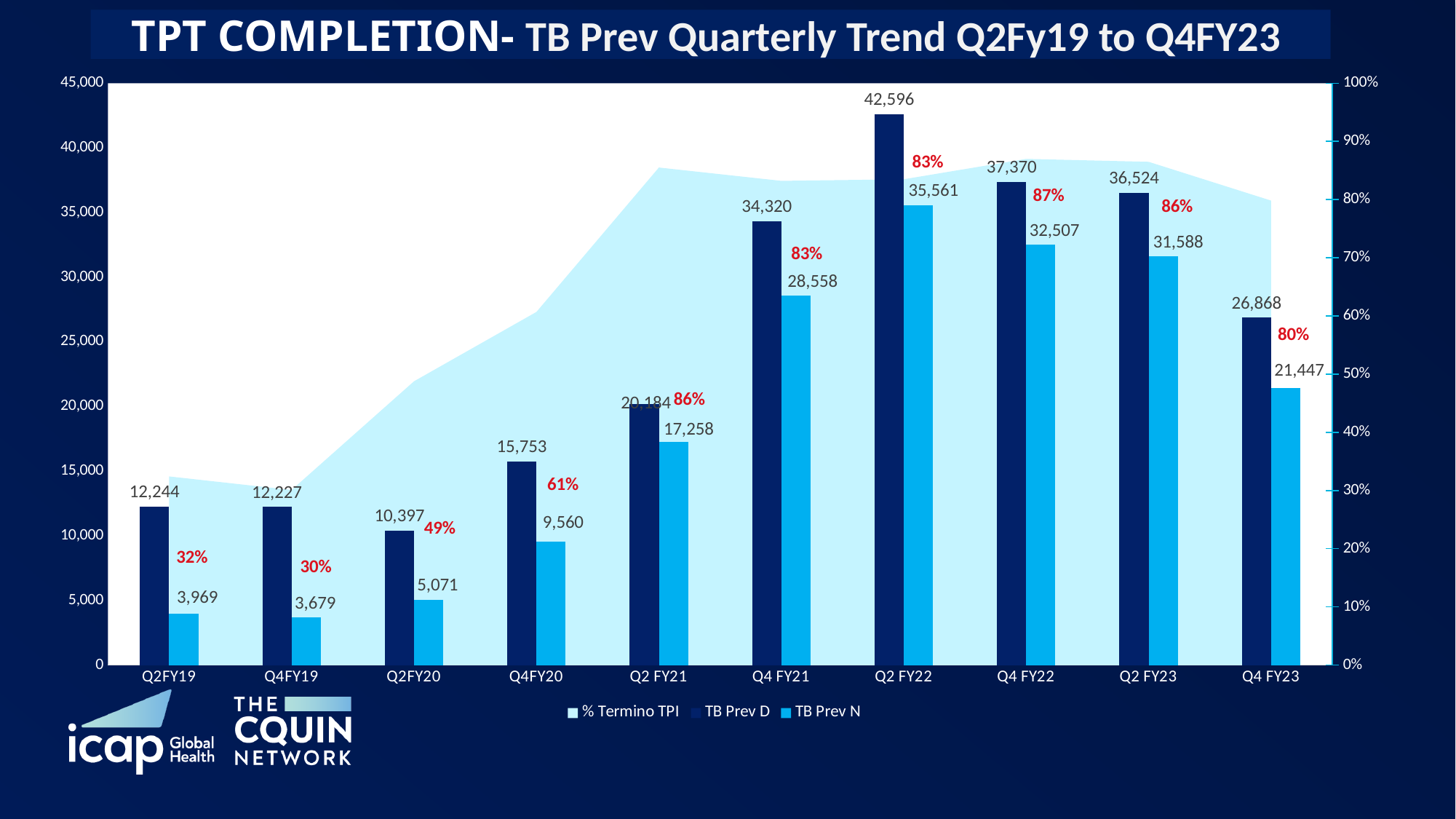
What is the % Termino TPI value for Q4 FY22? 87% How many quarters are shown on the x axis? 10 What is the difference between TB Prev D and TB Prev N for Q4 FY23? 5,421 What kind of chart is used to show the TB Prev D and TB Prev N series? Bar chart Which quarter has the highest % Termino TPI value? Q4 FY22 Does the % Termino TPI value rise or fall from Q2FY19 to Q4FY20? Rise How many series does the legend list? 3 What is the TB Prev N value for Q4 FY21? 28,558 Which quarter has the highest TB Prev D value? Q2 FY22 Which quarter has the lowest TB Prev N value? Q4FY19 What is the TB Prev D value for Q2 FY22? 42,596 Which quarter has the larger TB Prev N value, Q4 FY22 or Q2 FY23? Q4 FY22